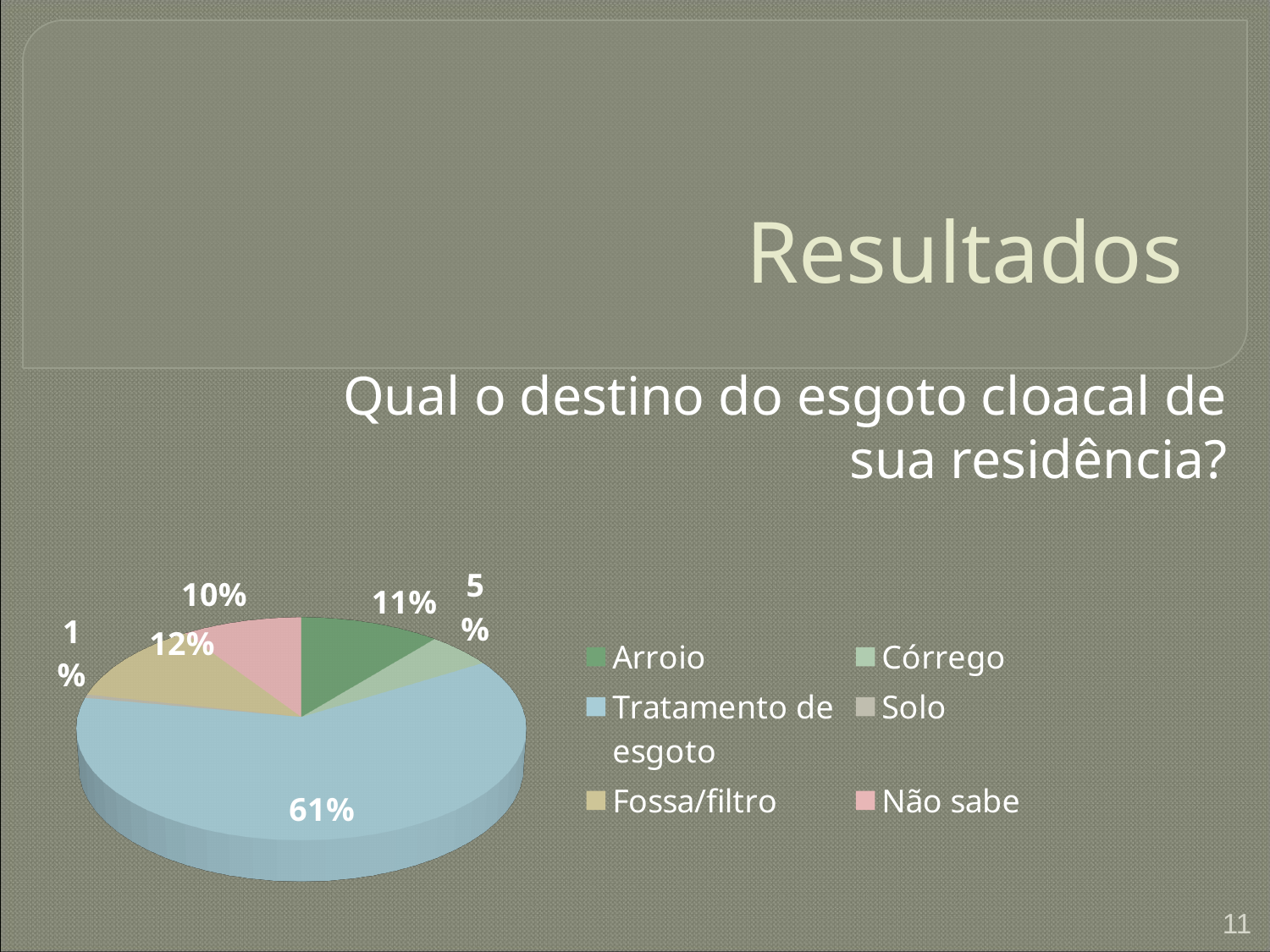
What percentage of the pie corresponds to Córrego? 5% What kind of chart is shown on the slide? pie chart What percentage of the pie corresponds to Não sabe? 10% Which category has the largest share of the pie? Tratamento de esgoto What percentage of the pie corresponds to Arroio? 11% Which is larger, the share for Arroio or the share for Córrego? Arroio What percentage of the pie corresponds to Tratamento de esgoto? 61% What percentage of the pie corresponds to Fossa/filtro? 12% How many categories does the legend list? 6 What question is the pie chart answering, according to the slide? Qual o destino do esgoto cloacal de sua residência? Which category has the smallest share of the pie? Solo What is the difference in percentage points between Tratamento de esgoto and Fossa/filtro? 49